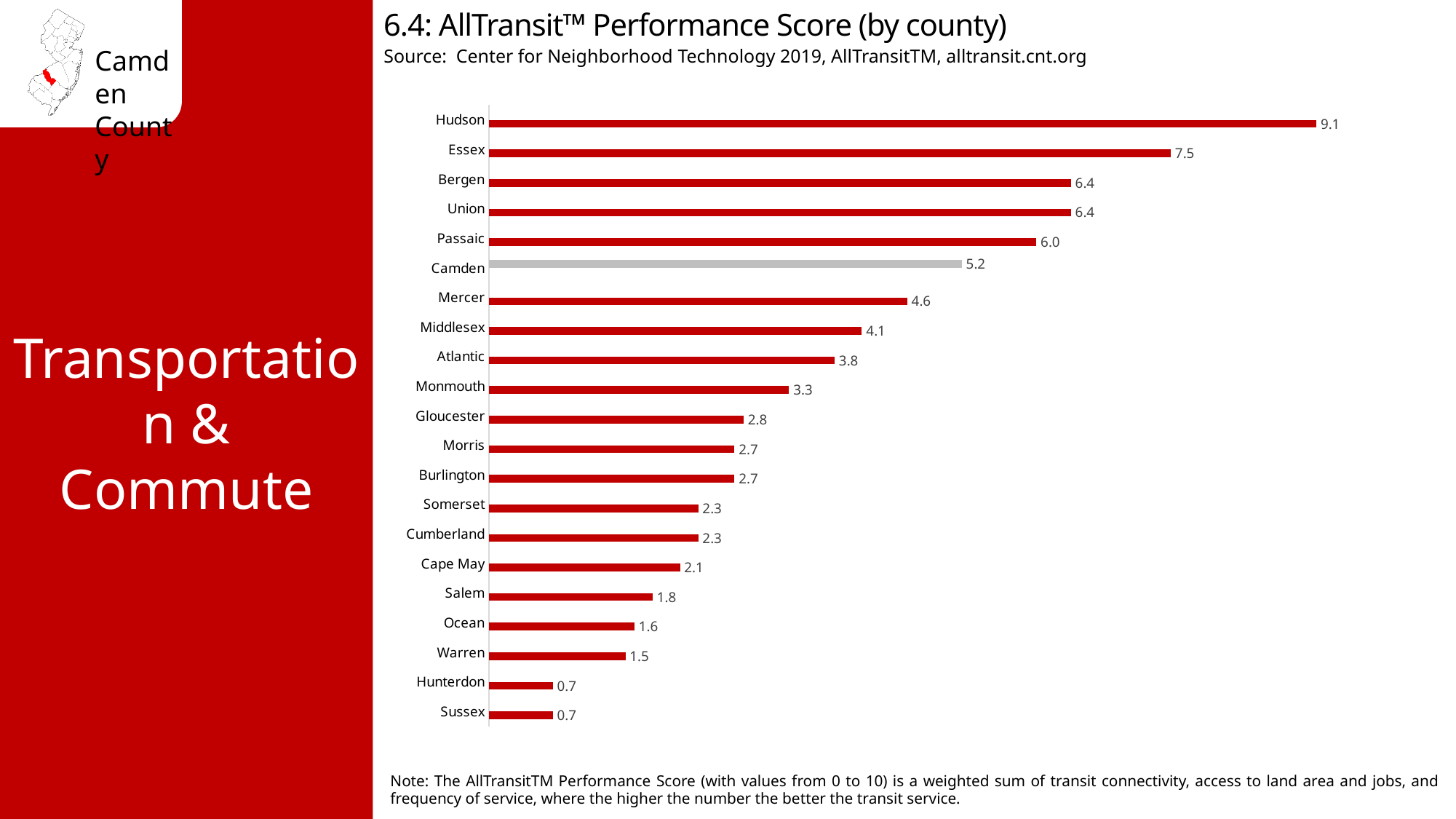
What is the difference between the AllTransit Performance Scores of Hudson and Essex? 1.6 What kind of chart is used to show the AllTransit Performance Score by county? Bar chart Which has a higher AllTransit Performance Score, Atlantic or Monmouth? Atlantic What is the AllTransit Performance Score for Gloucester? 2.8 What is the difference between the AllTransit Performance Scores of Camden and Mercer? 0.6 What is the AllTransit Performance Score for Mercer? 4.6 How many counties are shown in the chart? 21 Which county has the highest AllTransit Performance Score? Hudson Which has a higher AllTransit Performance Score, Passaic or Camden? Passaic What is the AllTransit Performance Score for Camden? 5.2 What is the AllTransit Performance Score for Hudson? 9.1 Which county's bar is shown in grey rather than red? Camden